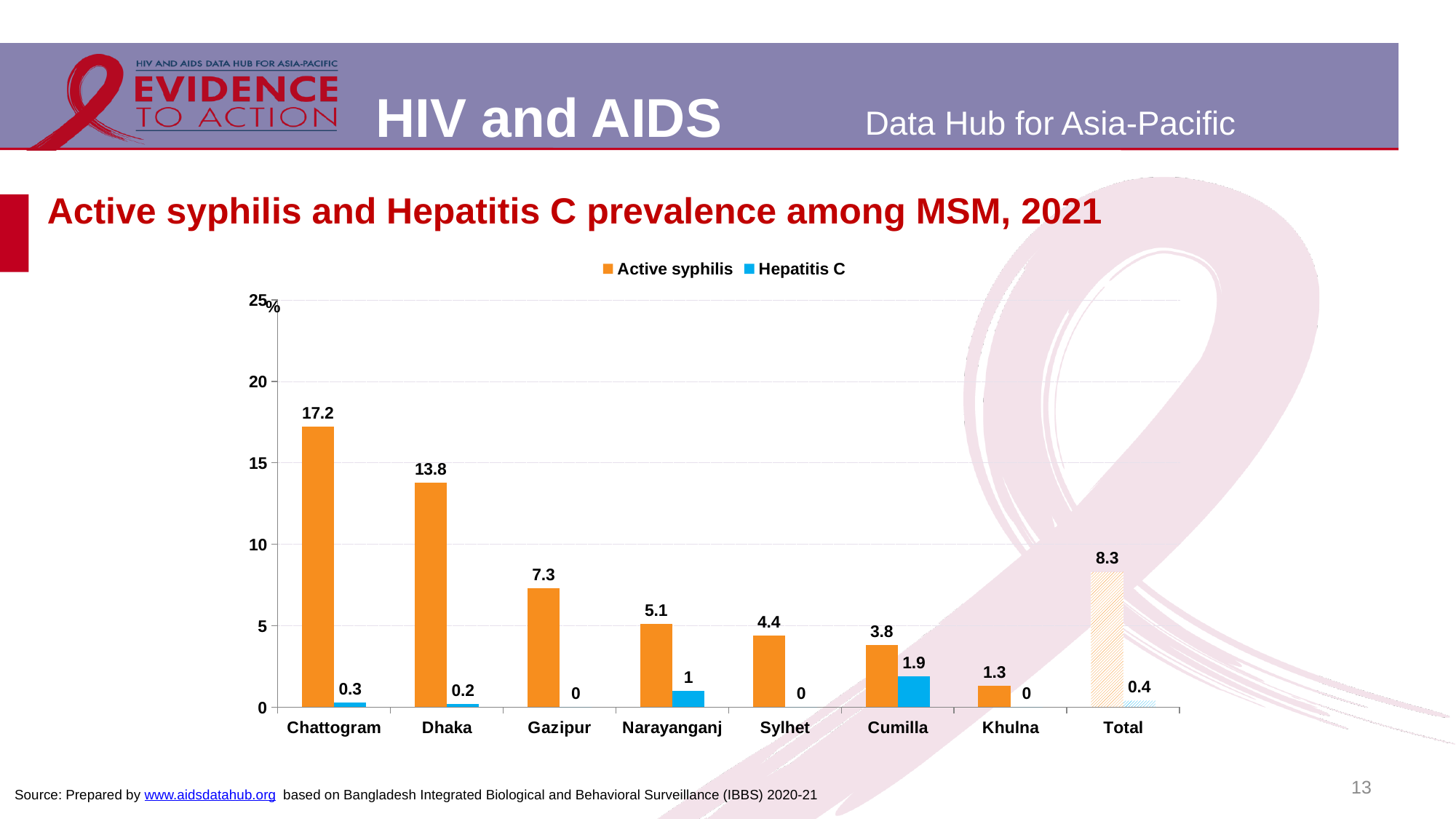
Which category has the lowest Active syphilis prevalence? Khulna What is the difference between the Active syphilis values for Chattogram and Dhaka? 3.4 How many series does the legend list? 2 Which category has the highest Active syphilis prevalence? Chattogram Is the Active syphilis value for Dhaka greater or less than 15? less What kind of chart is shown on the slide? bar chart Which colour represents Hepatitis C in the chart? blue What is the Active syphilis prevalence for Chattogram? 17.2 How many categories are shown on the x axis? 8 What is the Hepatitis C prevalence for Cumilla? 1.9 Which is larger, the Active syphilis value for Gazipur or for Narayanganj? Gazipur What is the Active syphilis value for Total? 8.3